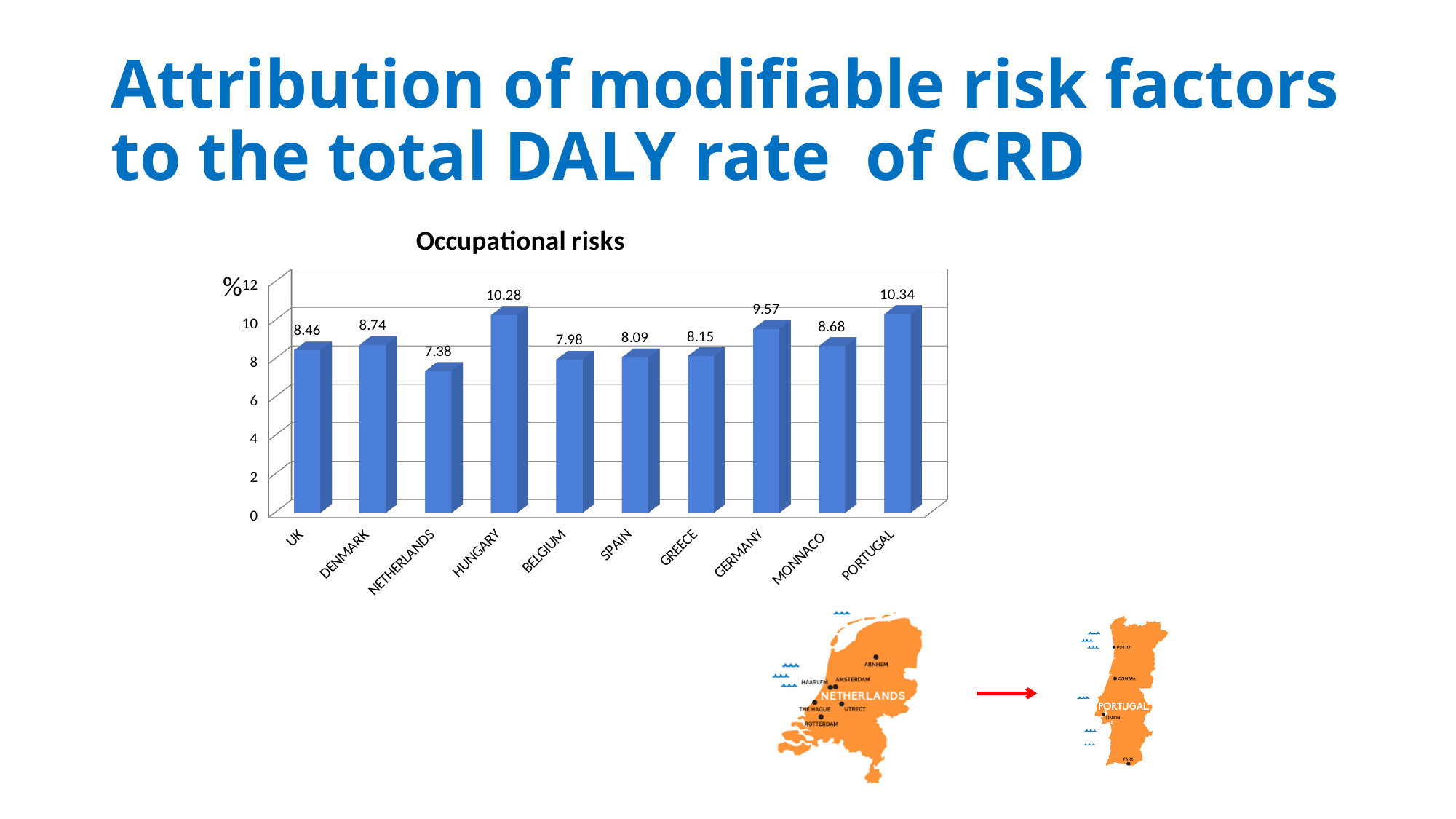
What is the value for Germany in the Occupational risks chart? 9.57 What is the difference between the values for Portugal and the Netherlands in the Occupational risks chart? 2.96 Is the value for Belgium in the Occupational risks chart greater or less than 8? less What unit is shown on the vertical axis of the Occupational risks chart? % What is the value for Hungary in the Occupational risks chart? 10.28 What kind of chart is the Occupational risks chart? bar chart Which country has the lowest value in the Occupational risks chart? Netherlands What is the value for the Netherlands in the Occupational risks chart? 7.38 Which has a larger value in the Occupational risks chart, Denmark or Monnaco? Denmark How many countries are shown in the Occupational risks chart? 10 Which country has the highest value in the Occupational risks chart? Portugal What is the title of the chart on the slide? Occupational risks